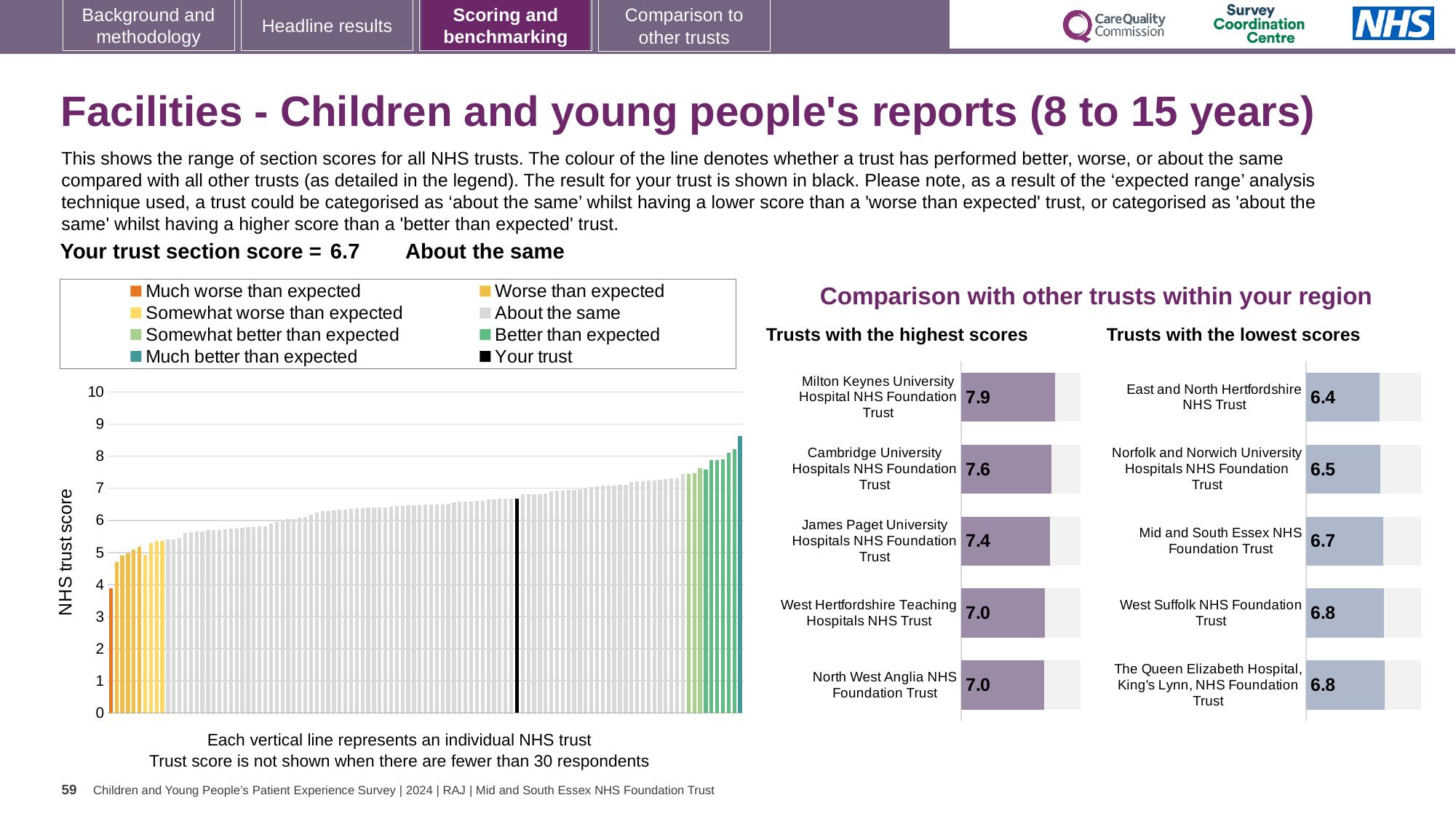
In the 'Trusts with the highest scores' chart, how many trusts are shown? 5 In the 'Trusts with the lowest scores' chart, what is the difference between the scores of West Suffolk NHS Foundation Trust and East and North Hertfordshire NHS Trust? 0.4 In the 'Trusts with the lowest scores' chart, what is the score for Norfolk and Norwich University Hospitals NHS Foundation Trust? 6.5 In the 'Trusts with the lowest scores' chart, which is larger: the score for Mid and South Essex NHS Foundation Trust or for Norfolk and Norwich University Hospitals NHS Foundation Trust? Mid and South Essex NHS Foundation Trust In the main NHS trust score chart on the left, is the value of the tallest bar greater or less than 8? greater In the main NHS trust score chart on the left, how many entries does the legend list? 8 In the 'Trusts with the highest scores' chart, what is the difference between the scores of Milton Keynes University Hospital NHS Foundation Trust and Cambridge University Hospitals NHS Foundation Trust? 0.3 In the 'Trusts with the highest scores' chart, which trust has the highest score? Milton Keynes University Hospital NHS Foundation Trust In the main NHS trust score chart on the left, do the trust scores rise or fall from left to right? Rise In the 'Trusts with the lowest scores' chart, which trust has the lowest score? East and North Hertfordshire NHS Trust In the 'Trusts with the highest scores' chart, what is the score for Milton Keynes University Hospital NHS Foundation Trust? 7.9 In the main NHS trust score chart on the left, what kind of chart is it? Bar chart